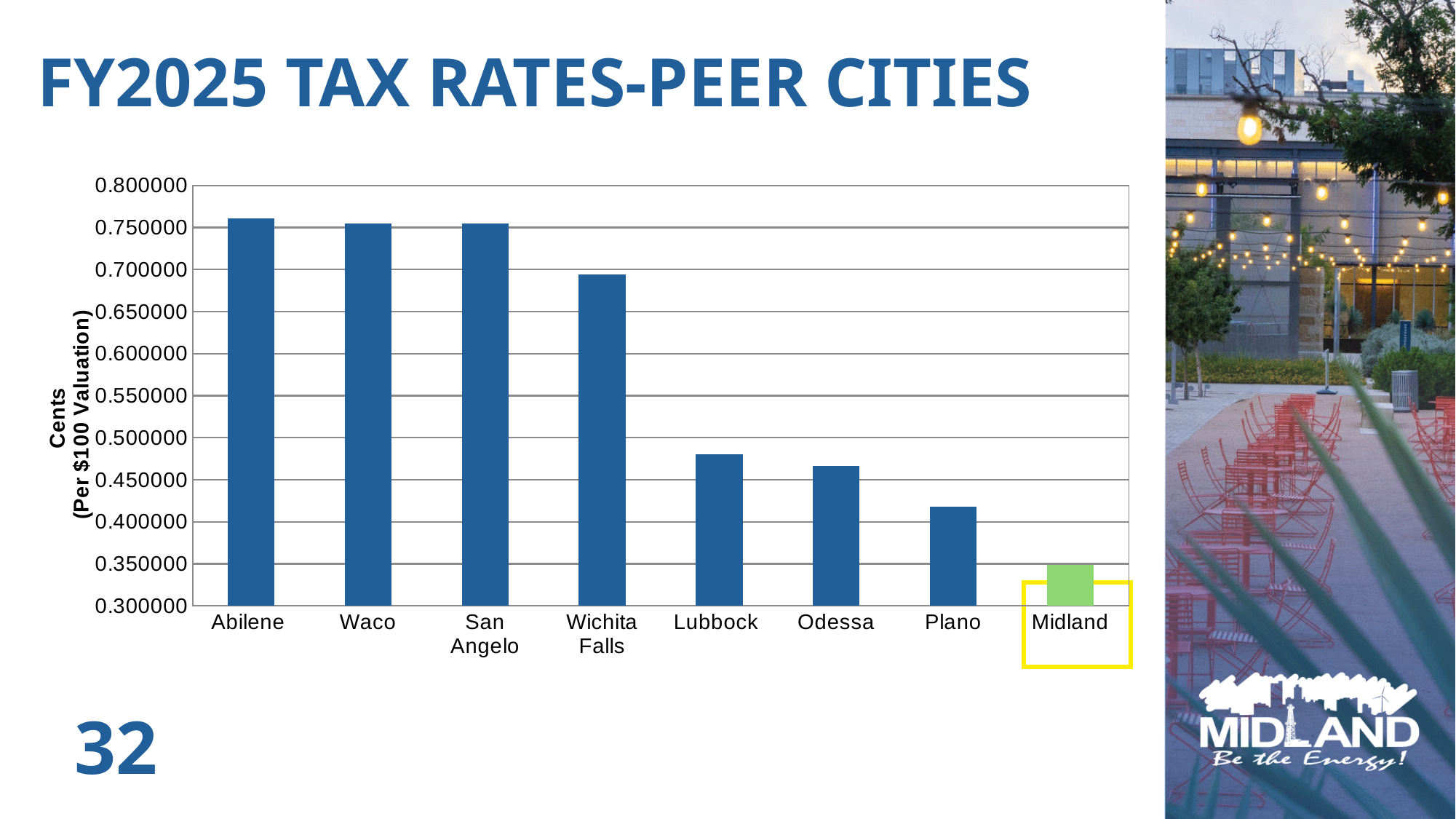
What kind of chart is shown on the slide? bar chart Is the value for Plano greater or less than 0.400000? greater Which has the higher tax rate, Lubbock or Odessa? Lubbock Is the value for Odessa greater or less than 0.450000? greater Is the value for Wichita Falls greater or less than 0.650000? greater Which city's bar is coloured green and highlighted with a yellow box? Midland Do the bar values rise or fall from left to right across the chart? fall How many cities are shown on the x axis of the chart? 8 Which city has the lowest tax rate in the chart? Midland Which city has the highest tax rate in the chart? Abilene Which has the higher tax rate, Plano or Wichita Falls? Wichita Falls